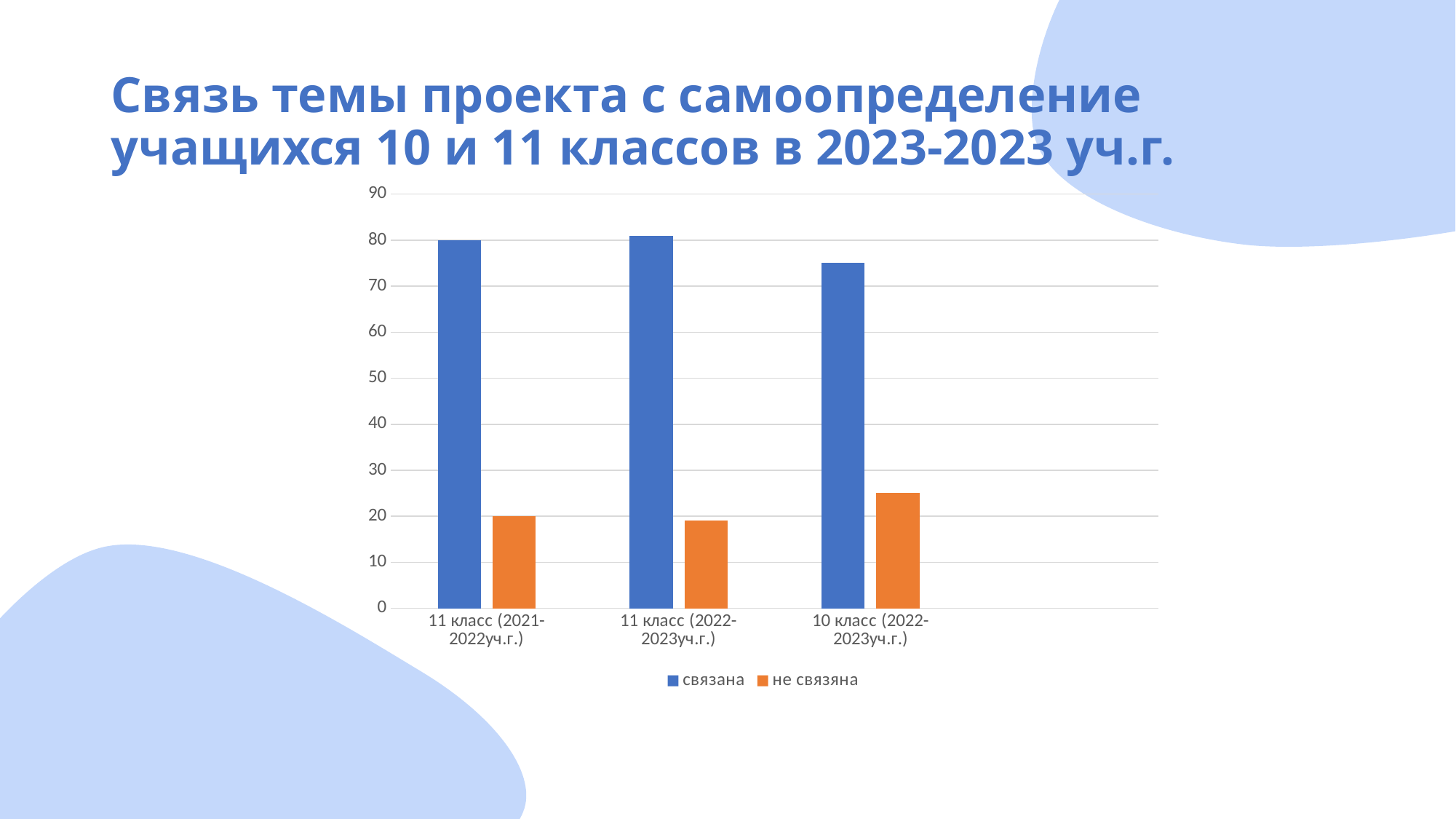
Which category has the lowest value for "связана"? 10 класс (2022-2023уч.г.) Which colour represents the "не связяна" series? orange How many categories are shown on the x axis? 3 What is the value of "не связяна" for "11 класс (2021-2022уч.г.)"? 20 Is the value of "не связяна" for "11 класс (2022-2023уч.г.)" greater or less than 30? less What kind of chart is shown on the slide? bar chart Is the value of "не связяна" for "10 класс (2022-2023уч.г.)" greater or less than 30? less What is the value of "связана" for "11 класс (2021-2022уч.г.)"? 80 For "11 класс (2022-2023уч.г.)", which is larger: "связана" or "не связяна"? связана Is the value of "связана" for "10 класс (2022-2023уч.г.)" greater or less than 70? greater Which category has the highest value for "не связяна"? 10 класс (2022-2023уч.г.) How many series does the legend list? 2